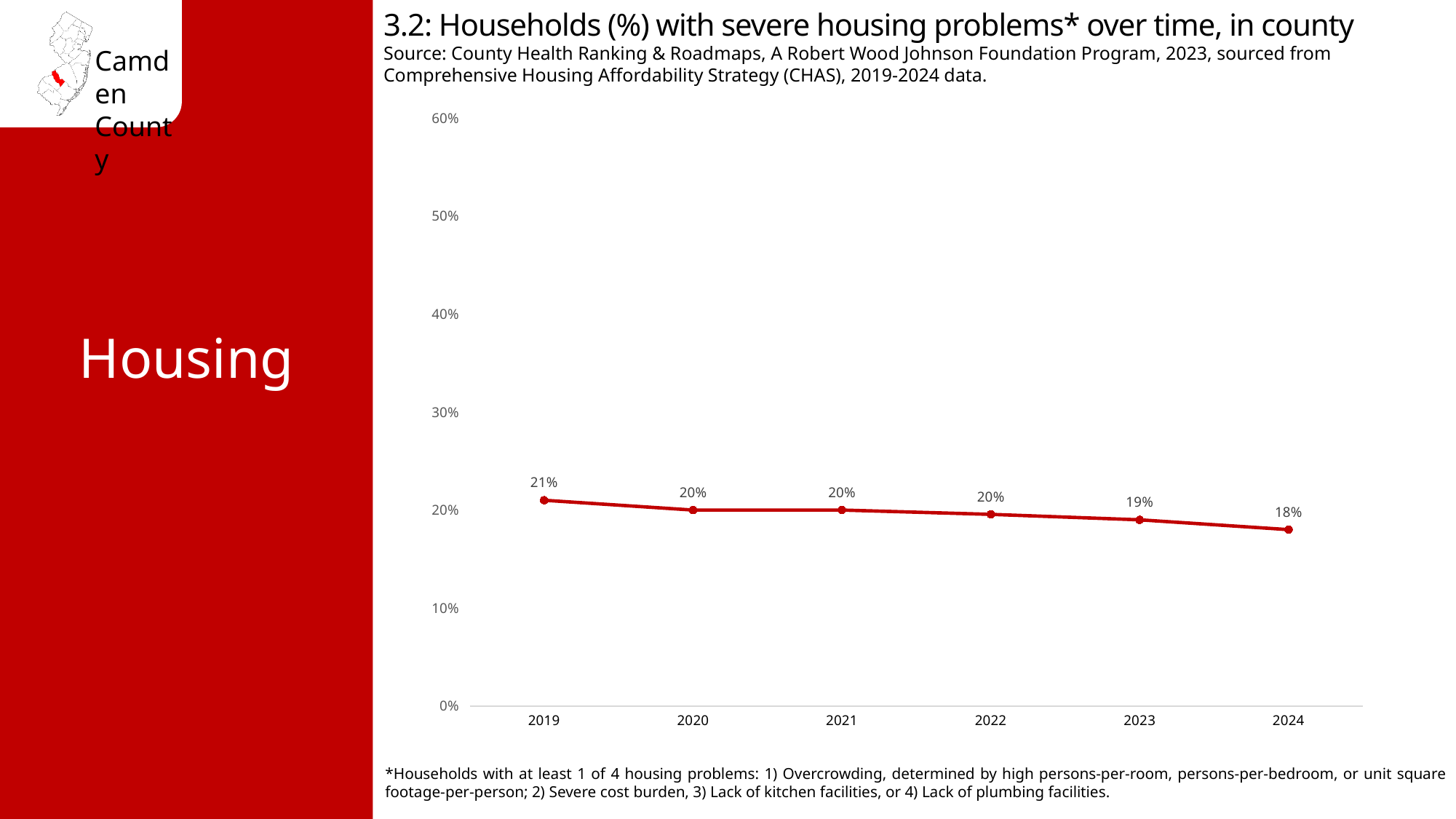
What is the value shown for 2021? 20% Which year has the highest percentage of households with severe housing problems? 2019 How many years are plotted on the chart? 6 What is the difference in percentage points between the 2019 value and the 2024 value? 3 What percentage of households had severe housing problems in 2024? 18% What kind of chart is shown on the slide? line chart What percentage of households had severe housing problems in 2019? 21% Which year has the lowest percentage of households with severe housing problems? 2024 Do the values rise or fall from 2019 to 2024? fall What is the value shown for 2023? 19% Is the value for 2022 greater or less than 30%? less Which year has a larger value, 2019 or 2023? 2019